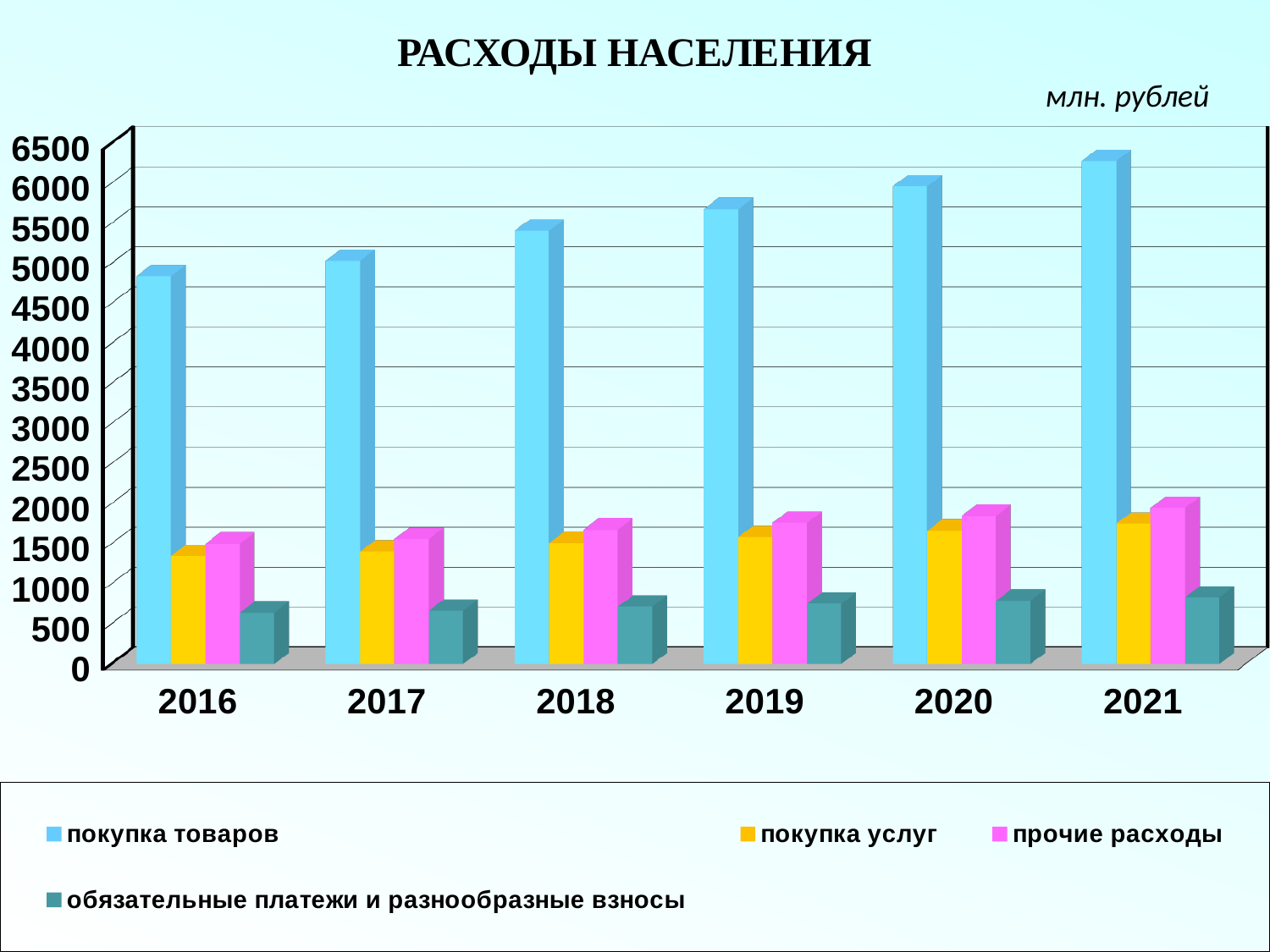
What unit of measurement is stated on the slide for the chart values? млн. рублей Is the value for покупка товаров in 2021 greater or less than 6000? greater Is the value for прочие расходы in 2021 greater or less than 1500? greater Do the values for покупка товаров rise or fall from 2016 to 2021? rise Is the value for покупка товаров in 2016 greater or less than 5000? less How many series does the legend list? 4 Which is larger in 2019: покупка услуг or прочие расходы? прочие расходы In which year is the value for покупка товаров highest? 2021 How many years are shown on the x axis? 6 What kind of chart is shown on the slide? bar chart In which year is the value for покупка товаров lowest? 2016